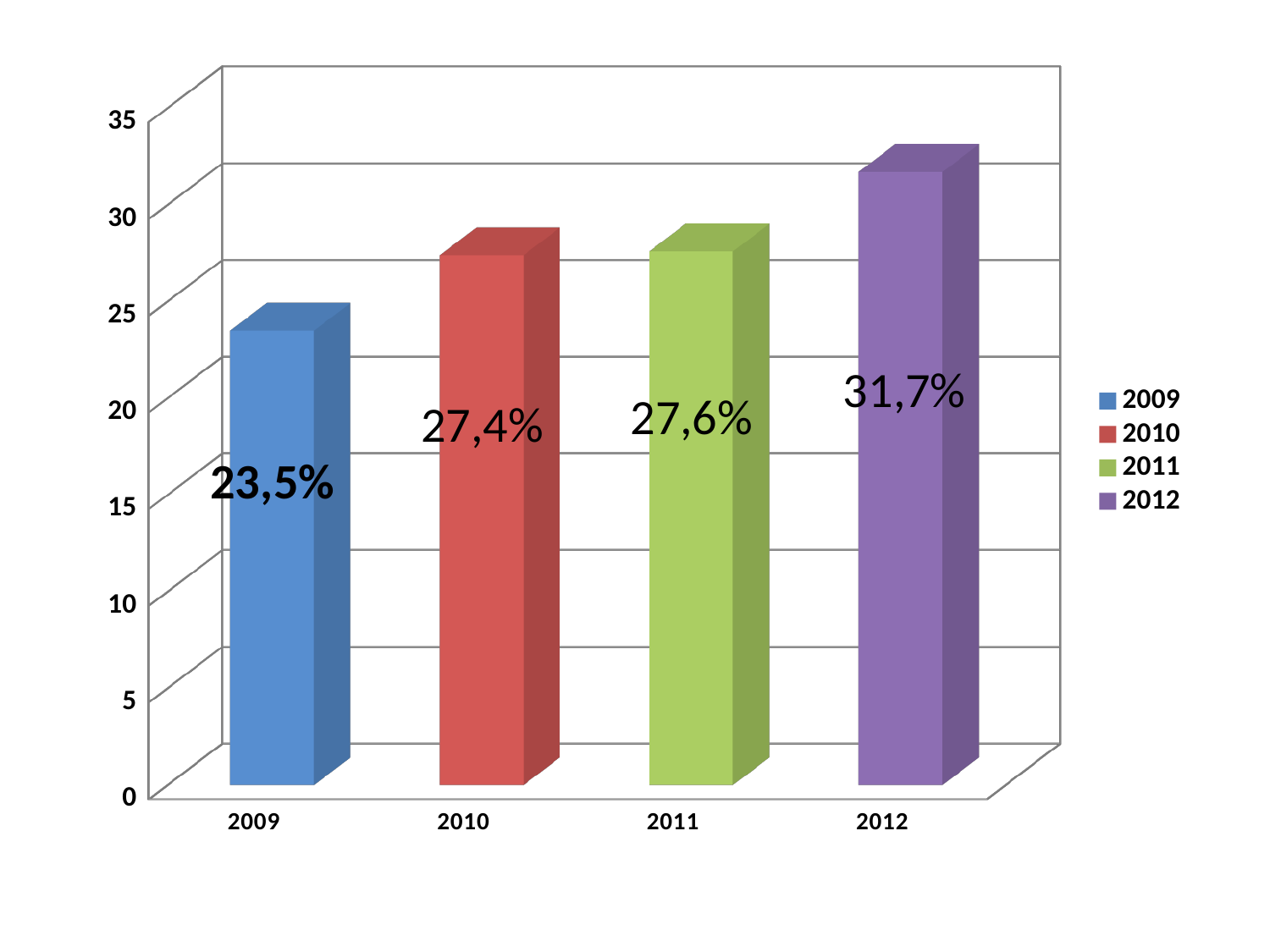
Is the value for 2012 greater or less than 30? greater What is the value for 2010? 27,4% Which is larger, the value for 2010 or the value for 2012? 2012 What is the value for 2009? 23,5% What is the value for 2012? 31,7% What kind of chart is shown on the slide? Bar chart How many bars are shown in the chart? 4 What is the value for 2011? 27,6% What is the difference between the values for 2012 and 2009? 8,2% Which year has the lowest value? 2009 Which year has the highest value? 2012 Do the values rise or fall from 2009 to 2012? Rise